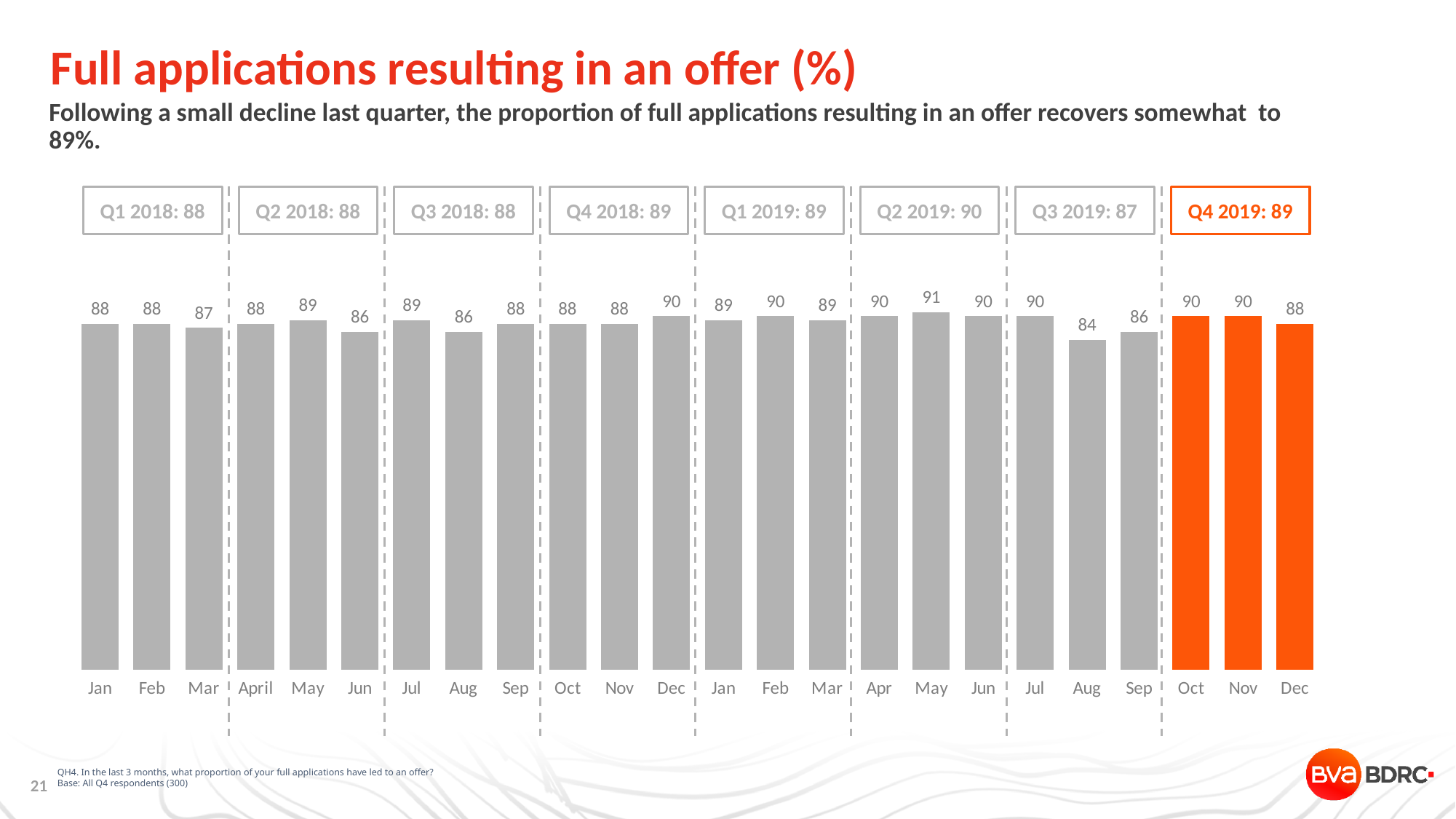
How many monthly bars are plotted in the chart? 24 What is the value for Aug in the Q3 2019 section of the chart? 84 Which month has the highest value in the chart? May (Q2 2019) What type of chart is shown on the slide? bar chart What is the value for May in the Q2 2019 section of the chart? 91 What is the difference between the highest bar (May 2019) and the lowest bar (Aug 2019)? 7 What is the value for Dec in the Q4 2019 section of the chart? 88 What is the difference between the Q2 2019 quarterly value and the Q3 2019 quarterly value shown in the boxes? 3 What quarterly value is shown in the box for Q3 2019? 87 Which is larger, the value for Jun in Q2 2018 or the value for Jun in Q2 2019? Jun in Q2 2019 Which month has the lowest value in the chart? Aug (Q3 2019) Which quarter's bars are highlighted in orange rather than grey? Q4 2019